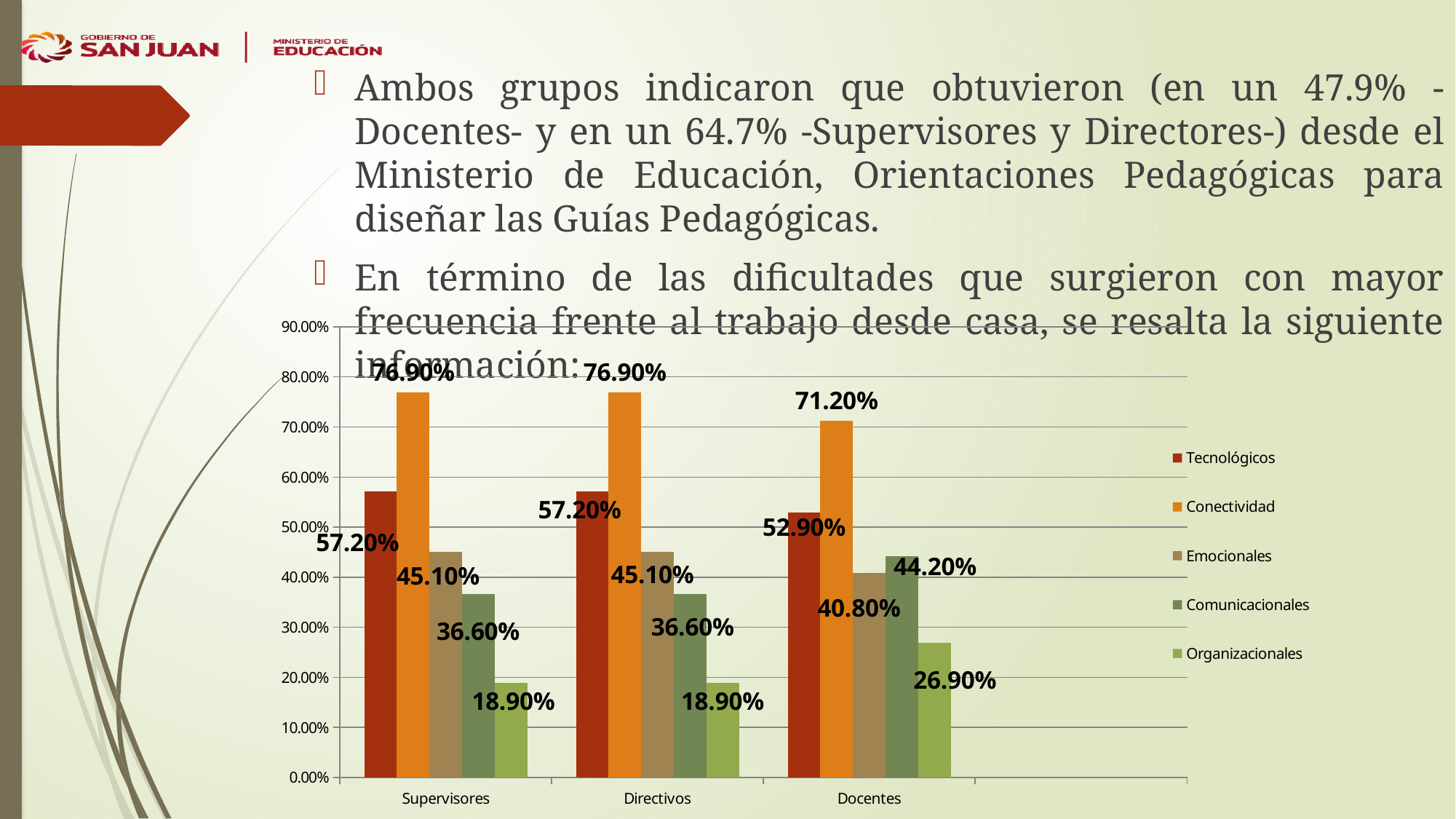
What is the Comunicacionales value for Docentes? 44.20% What is the Conectividad value for Docentes? 71.20% Which is larger for Docentes, Emocionales or Comunicacionales? Comunicacionales Which legend entry is shown in orange? Conectividad Is the Tecnológicos value for Docentes greater or less than 50.00%? greater How many series does the legend list? 5 Which series has the lowest value for Docentes? Organizacionales What is the Organizacionales value for Supervisores? 18.90% What kind of chart is shown on the slide? Bar chart Which series has the highest value for Directivos? Conectividad What is the difference between the Conectividad values for Supervisores and Docentes? 5.70% How many categories are shown on the x axis? 3